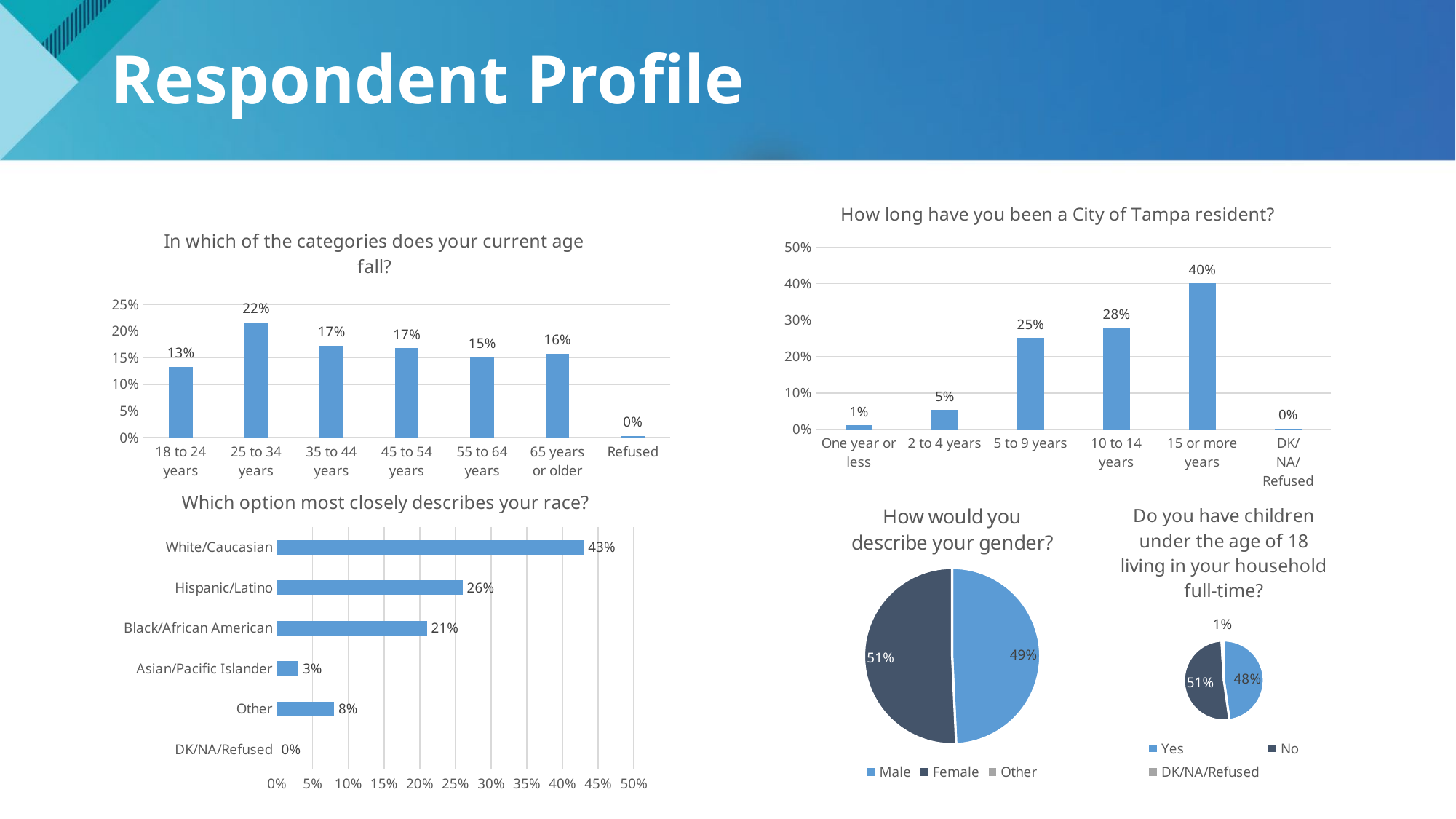
In the pie chart 'How would you describe your gender?', what share is Female? 51% In the chart 'Which option most closely describes your race?', what is the difference between the values for White/Caucasian and Black/African American? 22% In the chart 'In which of the categories does your current age fall?', which age category has the highest value? 25 to 34 years What kind of chart is 'Which option most closely describes your race?' Bar chart In the chart 'Which option most closely describes your race?', what is the value for Hispanic/Latino? 26% In the chart 'How long have you been a City of Tampa resident?', what is the value for 15 or more years? 40% In the chart 'In which of the categories does your current age fall?', what is the value for 25 to 34 years? 22% How many entries does the legend of the pie chart 'How would you describe your gender?' list? 3 In the pie chart 'Do you have children under the age of 18 living in your household full-time?', what share is Yes? 48% In the chart 'How long have you been a City of Tampa resident?', which of 5 to 9 years or 10 to 14 years has the larger value? 10 to 14 years In the chart 'In which of the categories does your current age fall?', what is the difference between the values for 25 to 34 years and 55 to 64 years? 7% In the chart 'How long have you been a City of Tampa resident?', how many categories are shown on the x axis? 6